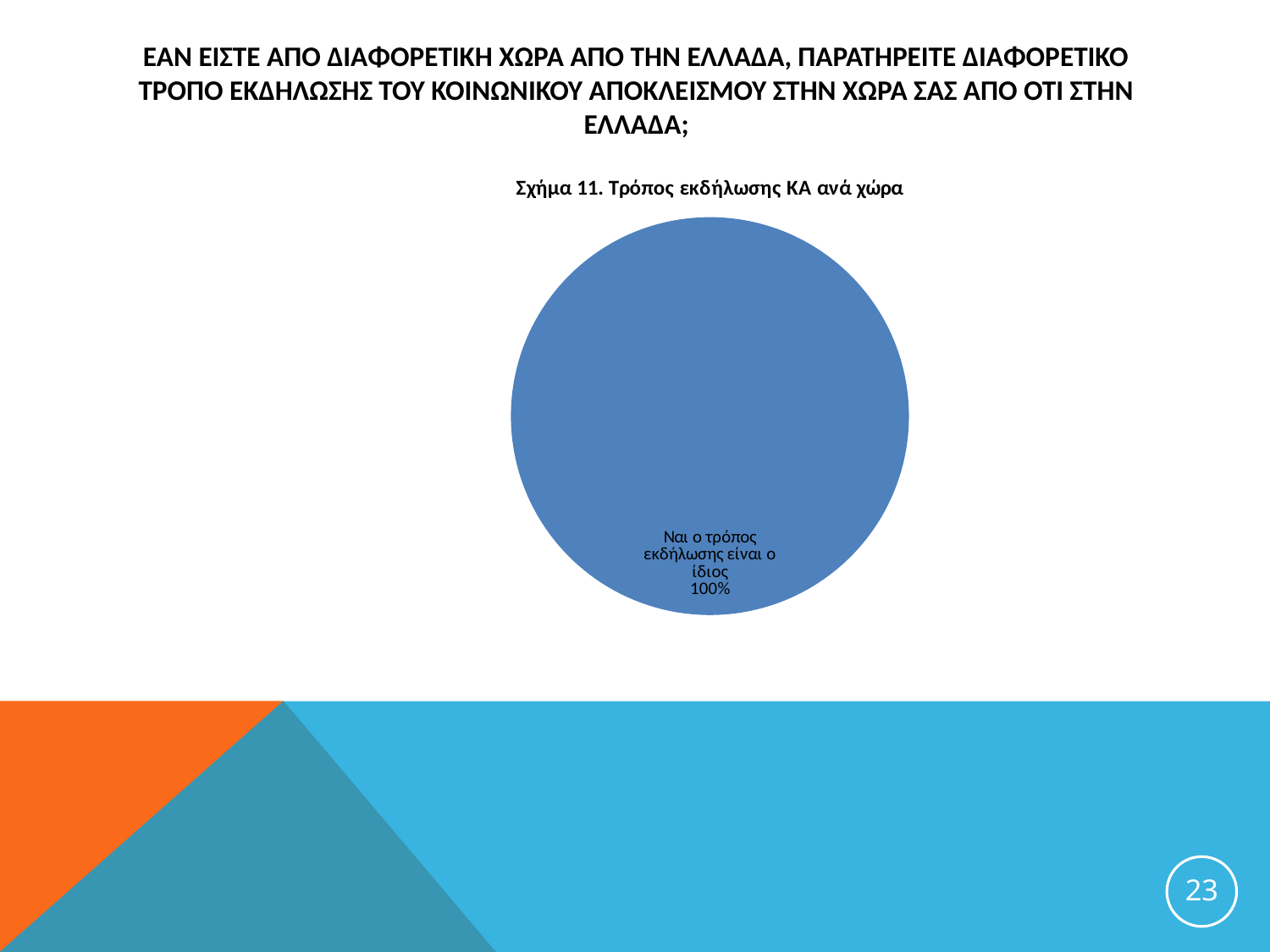
What kind of chart is shown on the slide? pie chart Is the share of the slice "Ναι ο τρόπος εκδήλωσης είναι ο ίδιος" greater or less than 50%? greater What is the title of the chart? Σχήμα 11. Τρόπος εκδήλωσης ΚΑ ανά χώρα Which category has the largest share of the pie chart? Ναι ο τρόπος εκδήλωσης είναι ο ίδιος What is the percentage printed on the pie chart's slice? 100% How many slices does the pie chart have? 1 What colour is the single slice of the pie chart? blue What share of the pie does the slice "Ναι ο τρόπος εκδήλωσης είναι ο ίδιος" represent? 100%